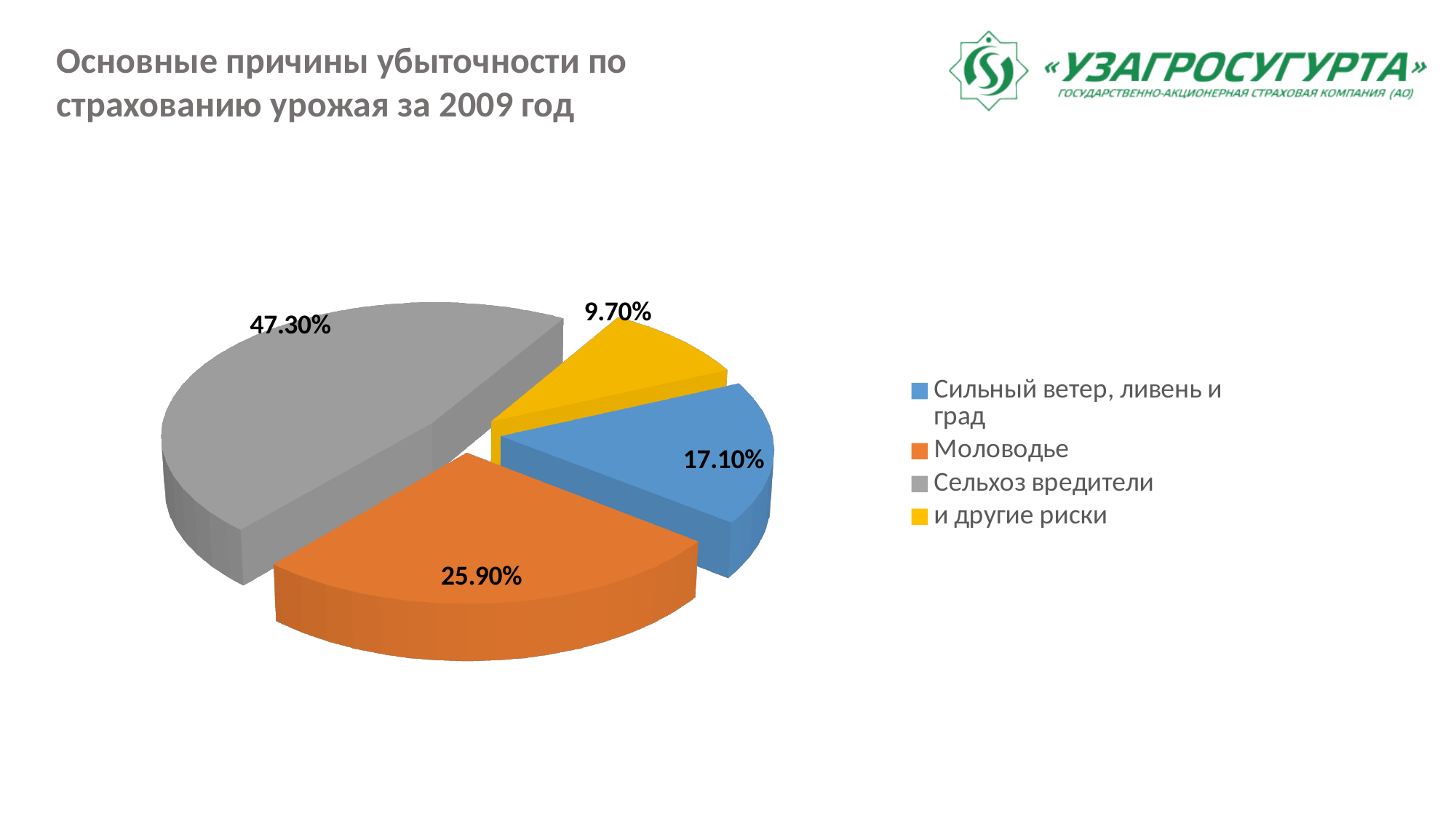
What is the value for the slice labelled и другие риски? 9.70% Which category has the smallest share of the pie? и другие риски What type of chart is shown on the slide? Pie chart What share of the pie does Сельхоз вредители account for? 47.30% Which category has the largest share of the pie? Сельхоз вредители What colour is the slice for Сельхоз вредители? Gray What percentage is shown for Сильный ветер, ливень и град? 17.10% How many slices does the pie chart have? 4 How many entries does the legend list? 4 What is the value shown for Моловодье? 25.90% Which is larger, the share for Моловодье or the share for Сильный ветер, ливень и град? Моловодье What is the difference between the shares of Сельхоз вредители and Моловодье? 21.40%